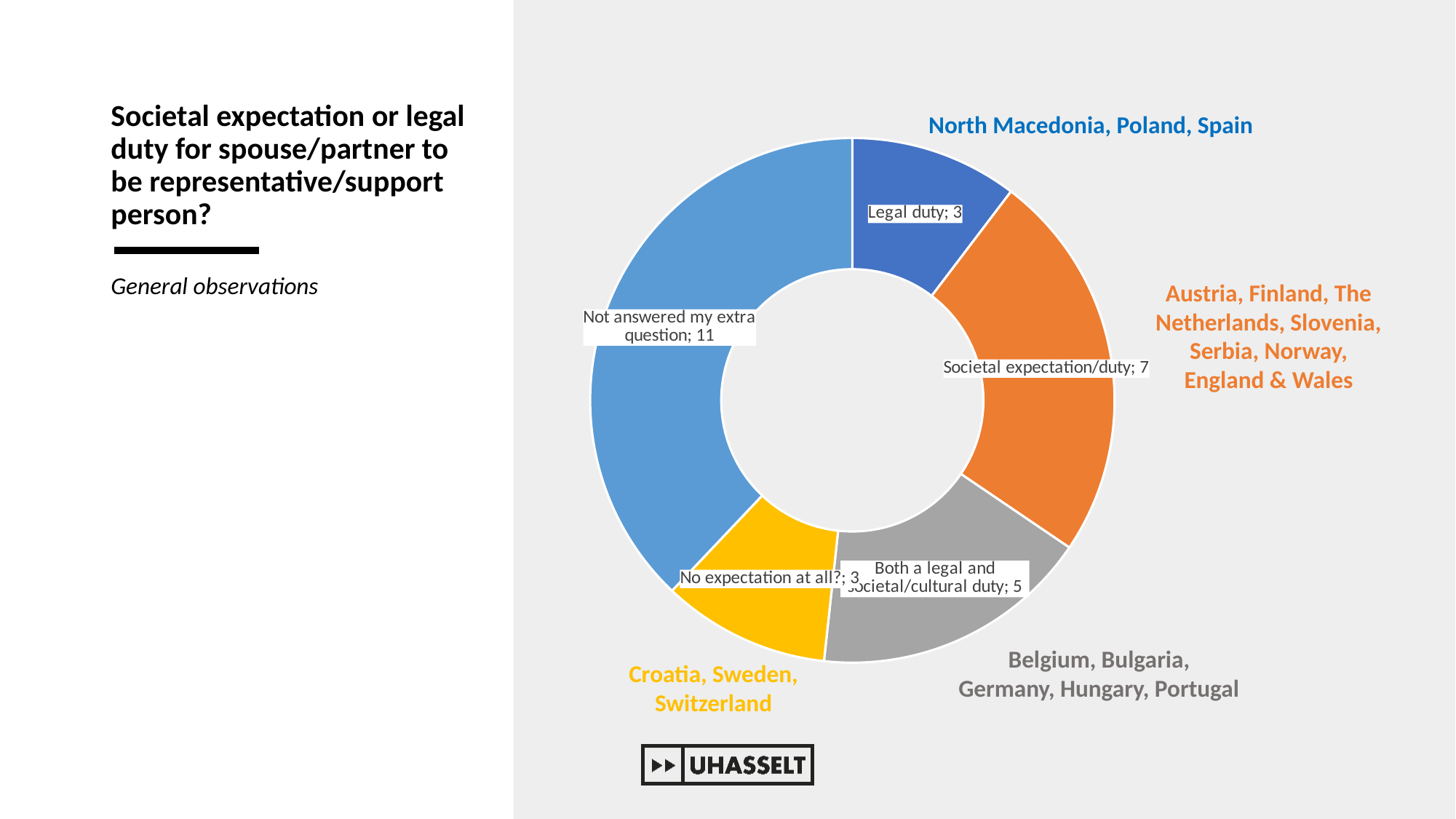
What kind of chart is shown on the slide? Doughnut chart What is the difference between the "Not answered my extra question" value and the "Societal expectation/duty" value? 4 How many categories (slices) does the chart have? 5 What value is shown for the "Societal expectation/duty" slice? 7 What value is shown for the "Legal duty" slice? 3 Which category has the largest value in the chart? Not answered my extra question Which countries are listed next to the orange "Societal expectation/duty" slice? Austria, Finland, The Netherlands, Slovenia, Serbia, Norway, England & Wales Which is larger: the value for "Societal expectation/duty" or the value for "Both a legal and societal/cultural duty"? Societal expectation/duty What is the total of all the slice values in the chart? 29 What value is shown for the "Both a legal and societal/cultural duty" slice? 5 What value is shown for the "Not answered my extra question" slice? 11 What is the difference between the "Societal expectation/duty" value and the "Both a legal and societal/cultural duty" value? 2